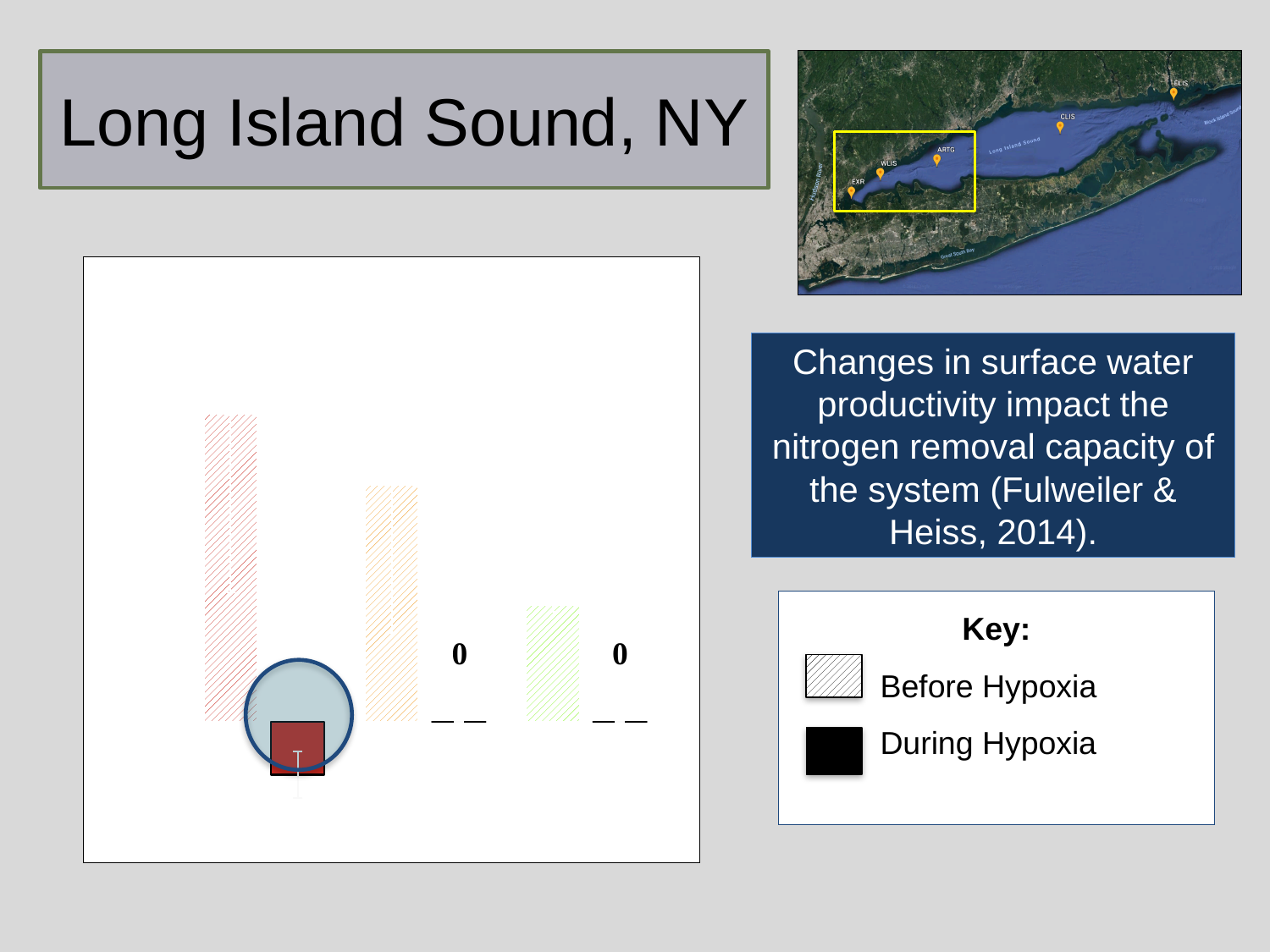
Do the hatched 'Before Hypoxia' bars rise or fall from left to right? fall Is the leftmost hatched bar or the middle hatched bar taller? the leftmost hatched bar Which of the hatched 'Before Hypoxia' bars is the tallest? the leftmost (red) bar What value is printed for 'During Hypoxia' next to the rightmost (green) bar group? 0 How many hatched 'Before Hypoxia' bars are plotted in the chart? 3 How many series does the key list for the chart? 2 According to the key, what fill represents 'During Hypoxia'? solid black How many bar groups show a printed 'During Hypoxia' value of 0? 2 According to the key, what fill pattern represents 'Before Hypoxia'? diagonal hatching What kind of chart is shown on the left of the slide? bar chart Which of the hatched 'Before Hypoxia' bars is the shortest? the rightmost (green) bar What value is printed for 'During Hypoxia' next to the middle (orange) bar group? 0